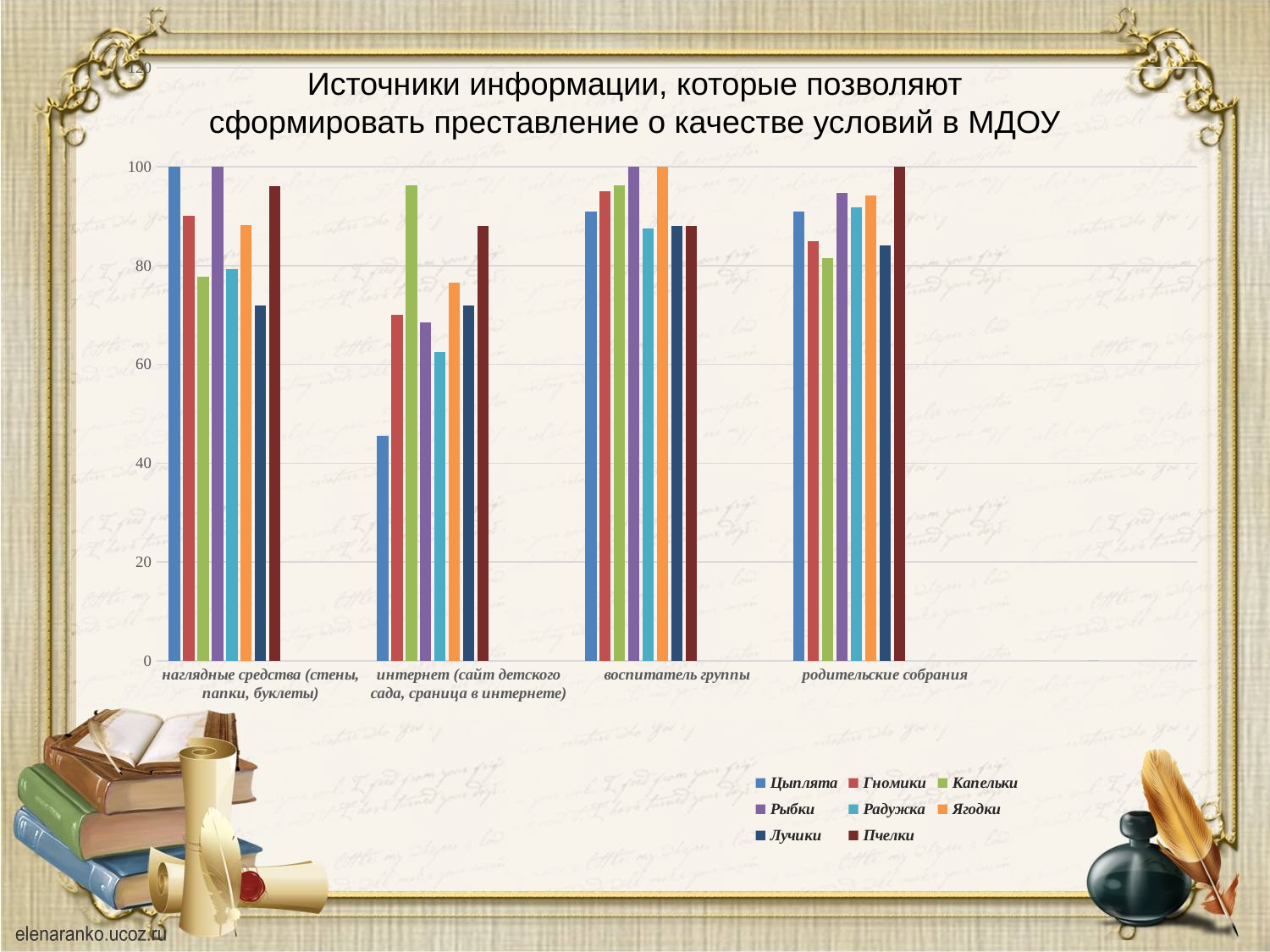
Is the value for Цыплята in the category интернет (сайт детского сада, сраница в интернете) greater or less than 60? less Which series has the highest value in the category интернет (сайт детского сада, сраница в интернете)? Капельки Which series has the lowest value in the category интернет (сайт детского сада, сраница в интернете)? Цыплята For the series Капельки, which category has the larger value: наглядные средства (стены, папки, буклеты) or интернет (сайт детского сада, сраница в интернете)? интернет (сайт детского сада, сраница в интернете) What is the value for Пчелки in the category родительские собрания? 100 Is the value for Гномики in the category родительские собрания greater or less than 80? greater What is the value for Цыплята in the category наглядные средства (стены, папки, буклеты)? 100 What colour represents the series Ягодки in the chart's legend? orange How many series does the chart's legend list? 8 How many categories are shown along the x axis of the chart? 4 Is the value for Лучики in the category наглядные средства (стены, папки, буклеты) greater or less than 80? less What kind of chart is shown on the slide? bar chart